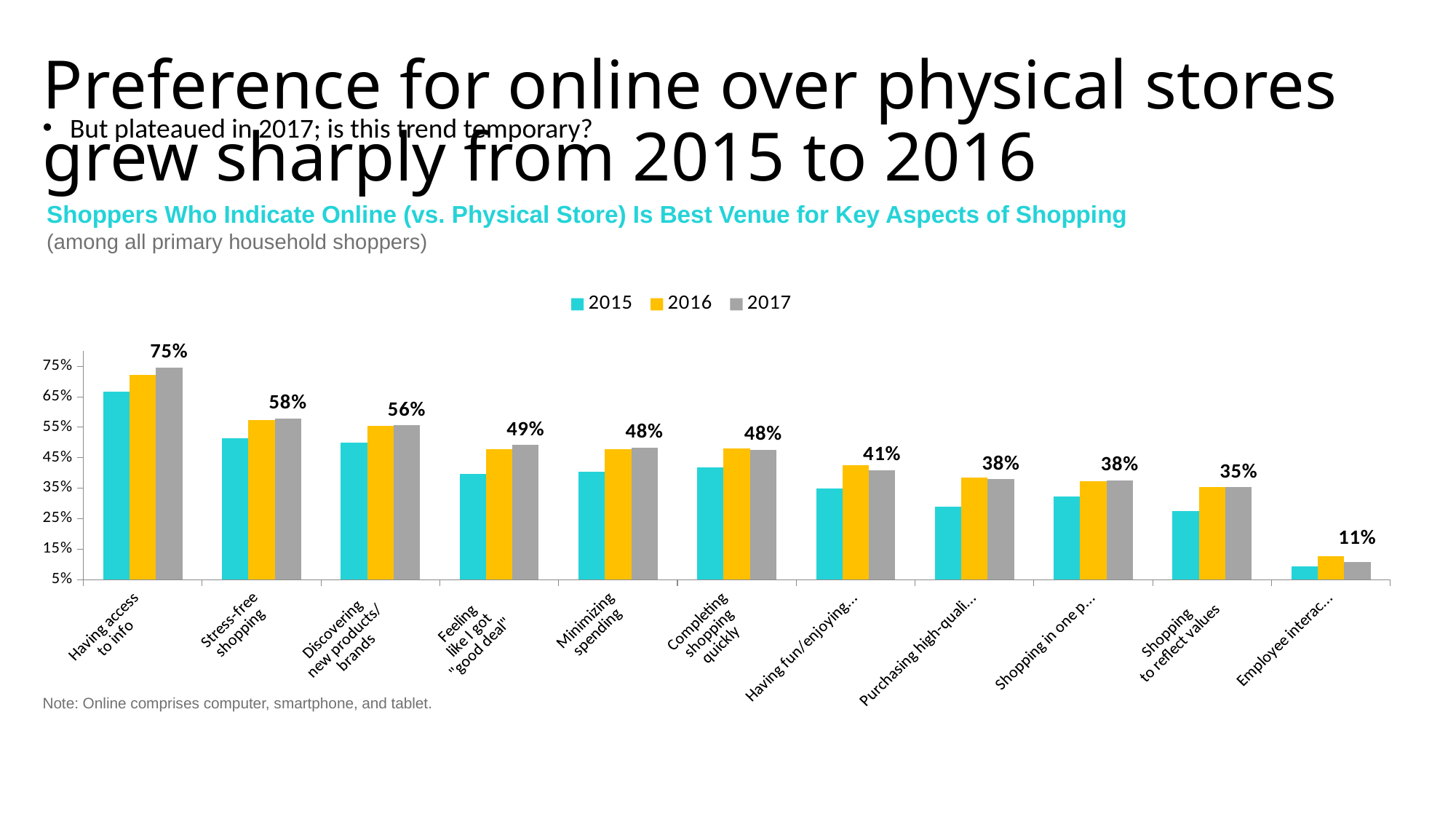
What is the 2017 value for "Having access to info"? 75% For "Having access to info", do the values rise or fall from 2015 to 2017? Rise Which has the larger 2017 value: "Feeling like I got 'good deal'" or "Minimizing spending"? Feeling like I got "good deal" How many series does the legend list? 3 How many categories are shown on the x axis? 11 What kind of chart is shown on the slide? Bar chart Which category has the highest 2017 value? Having access to info Is the 2015 value for "Having access to info" greater or less than 55%? greater What is the 2017 value for "Stress-free shopping"? 58% What is the difference between the 2017 values for "Having access to info" and "Stress-free shopping"? 17 percentage points What is the 2017 value for "Shopping to reflect values"? 35% Is the 2015 value for "Shopping to reflect values" greater or less than 35%? less